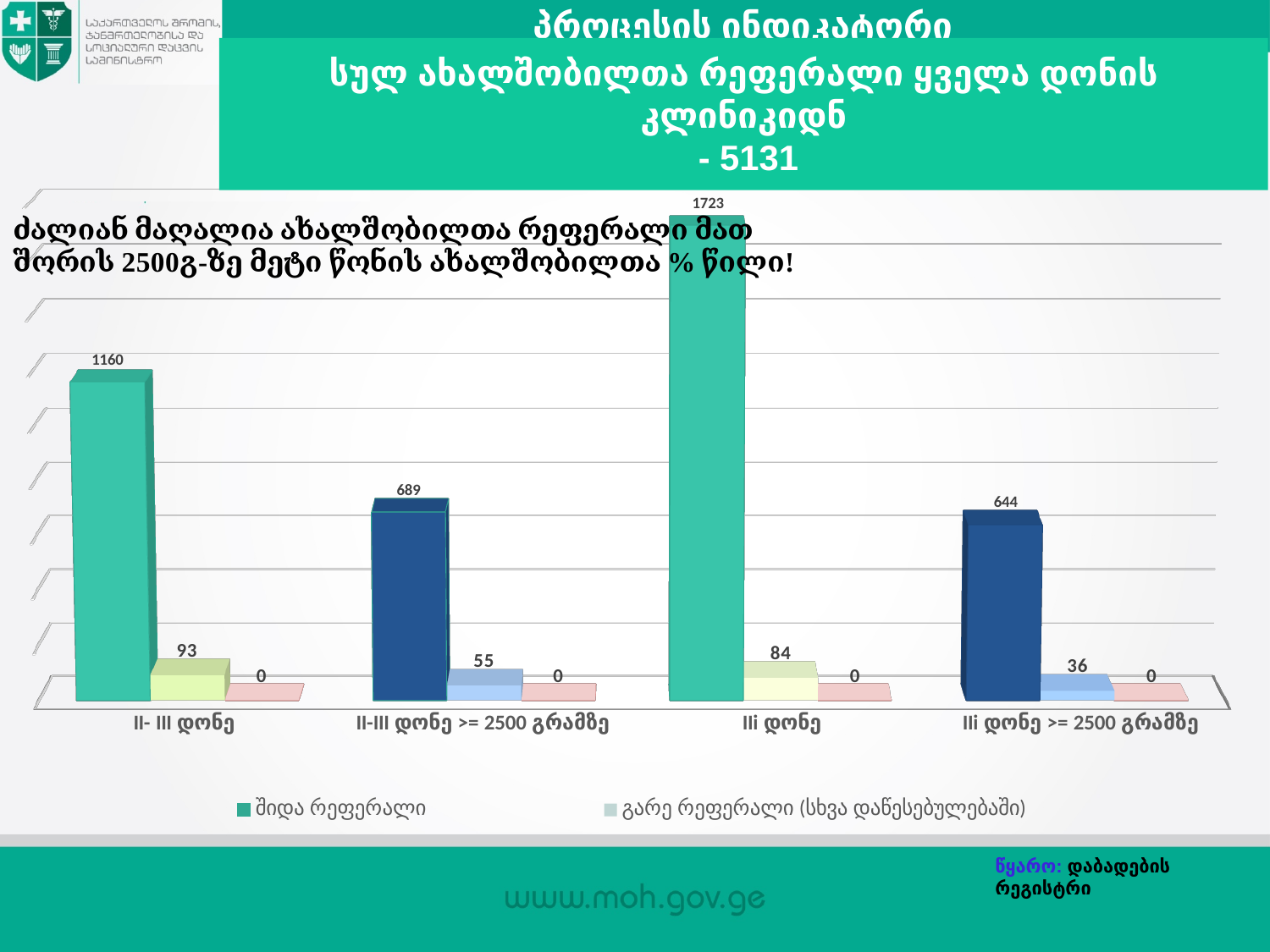
How many categories are shown on the x axis? 4 What is the difference between the tallest bars of 'IIi დონე' and 'II- III დონე'? 563 What is the value of the second (light-coloured) bar in the 'IIi დონე >= 2500 გრამზე' category? 36 What is the value of the second (light-coloured) bar in the 'II- III დონე' category? 93 What kind of chart is shown on the slide? Bar chart Which is larger: the second bar in 'II-III დონე >= 2500 გრამზე' or the second bar in 'IIi დონე'? IIi დონე (84) Which category has the highest tallest bar? IIi დონე What is the value of the tallest bar in the 'IIi დონე' category? 1723 Which category has the lowest tallest bar? IIi დონე >= 2500 გრამზე What is the value of the tallest bar in the 'II- III დონე' category? 1160 What is the value of the tallest bar in the 'IIi დონე >= 2500 გრამზე' category? 644 What is the value of the tallest bar in the 'II-III დონე >= 2500 გრამზე' category? 689